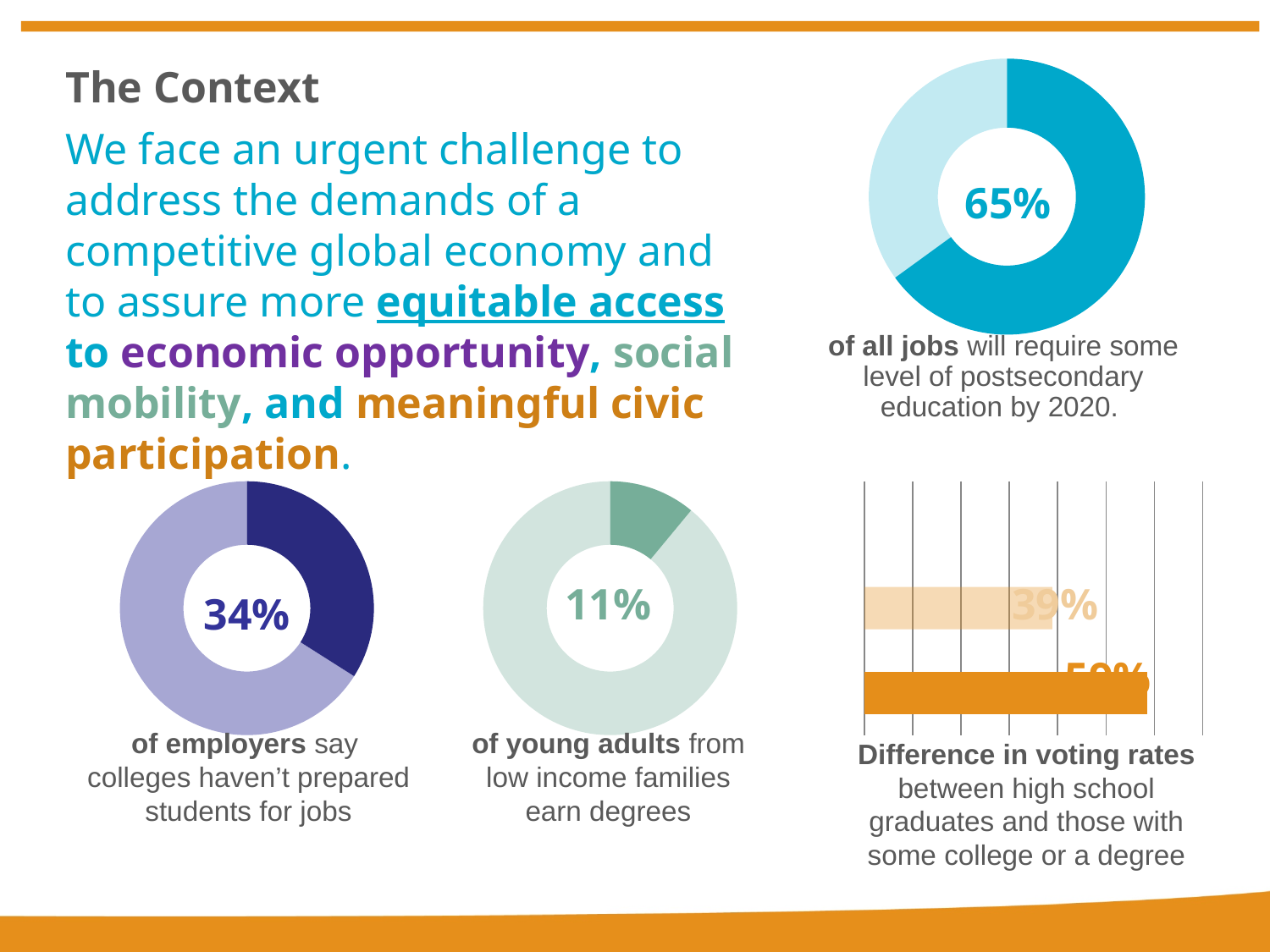
What percentage is shown in the centre of the top-right donut chart about jobs requiring postsecondary education by 2020? 65% Which of the three donut charts shows the smallest highlighted share: the 'of all jobs' chart, the 'of employers' chart, or the 'of young adults' chart? the 'of young adults' chart What kind of chart is used for the 'of all jobs' statistic in the top right of the slide? donut chart Which of the three donut charts shows the largest highlighted share: the 'of all jobs' chart, the 'of employers' chart, or the 'of young adults' chart? the 'of all jobs' chart In the 'Difference in voting rates' bar chart, how many bars are plotted? 2 What percentage is shown in the centre of the donut chart about employers saying colleges haven't prepared students for jobs? 34% What kind of chart is used for the 'Difference in voting rates' figure in the bottom right of the slide? bar chart What is the difference between the percentage in the 'of employers' donut chart and the percentage in the 'of young adults' donut chart? 23% What percentage is shown in the centre of the donut chart about young adults from low income families earning degrees? 11% In the 'Difference in voting rates' bar chart, what value is labelled on the top (lighter) bar? 39% In the 'Difference in voting rates' bar chart, which bar is longer, the top bar or the bottom bar? the bottom bar How many donut charts are on the slide? 3